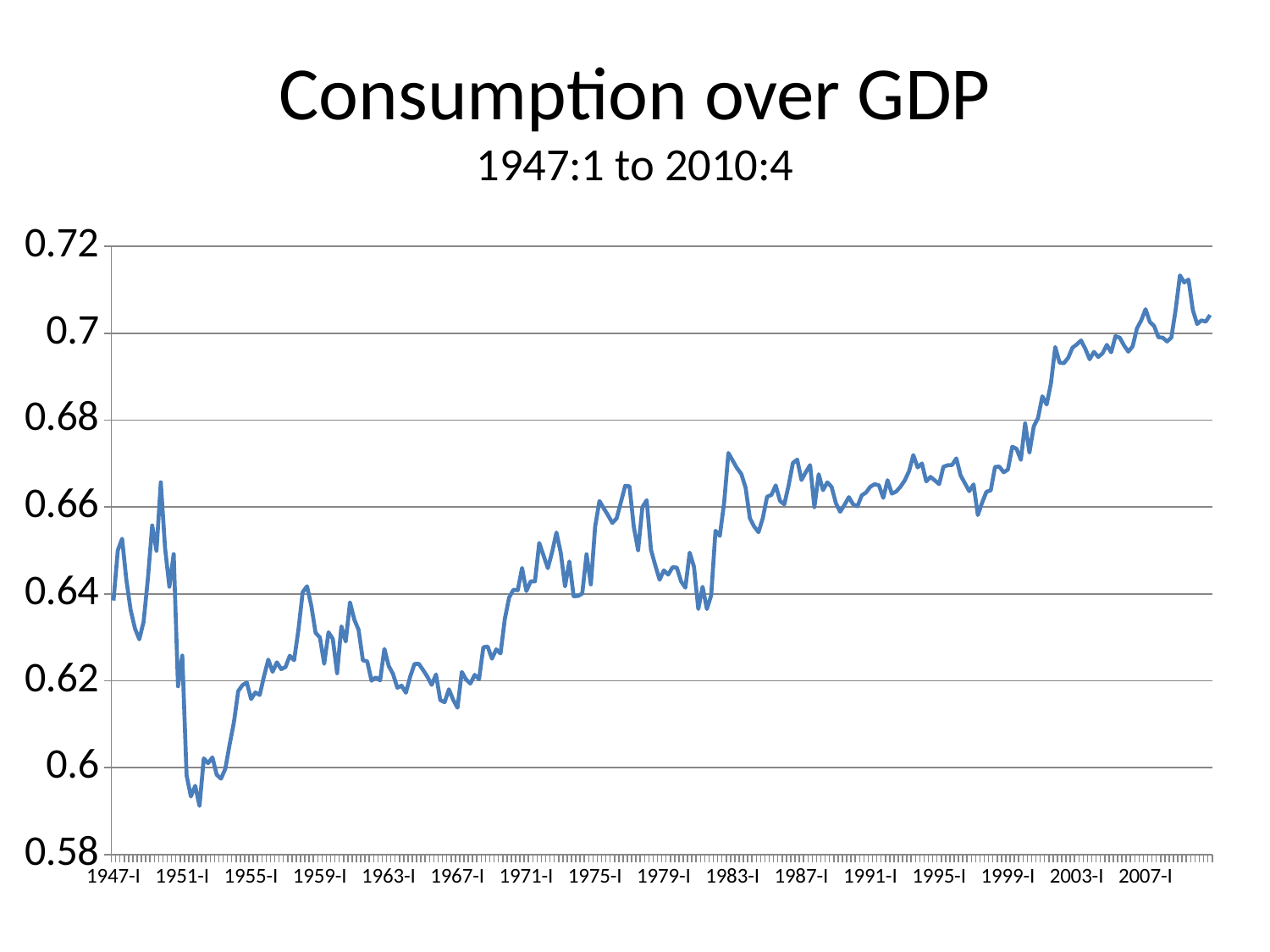
What kind of chart is shown on the slide? line chart Is the value at 1999-I greater or less than 0.66? greater Which is larger, the value at 2003-I or the value at 1955-I? 2003-I Is the value at 2003-I greater or less than 0.68? greater Overall, do the values rise or fall from 1947-I to the end of the series? rise What period does the subtitle say the chart covers? 1947:1 to 2010:4 What is the title of the chart? Consumption over GDP How many data series are plotted on the chart? 1 Is the highest value on the chart greater or less than 0.7? greater